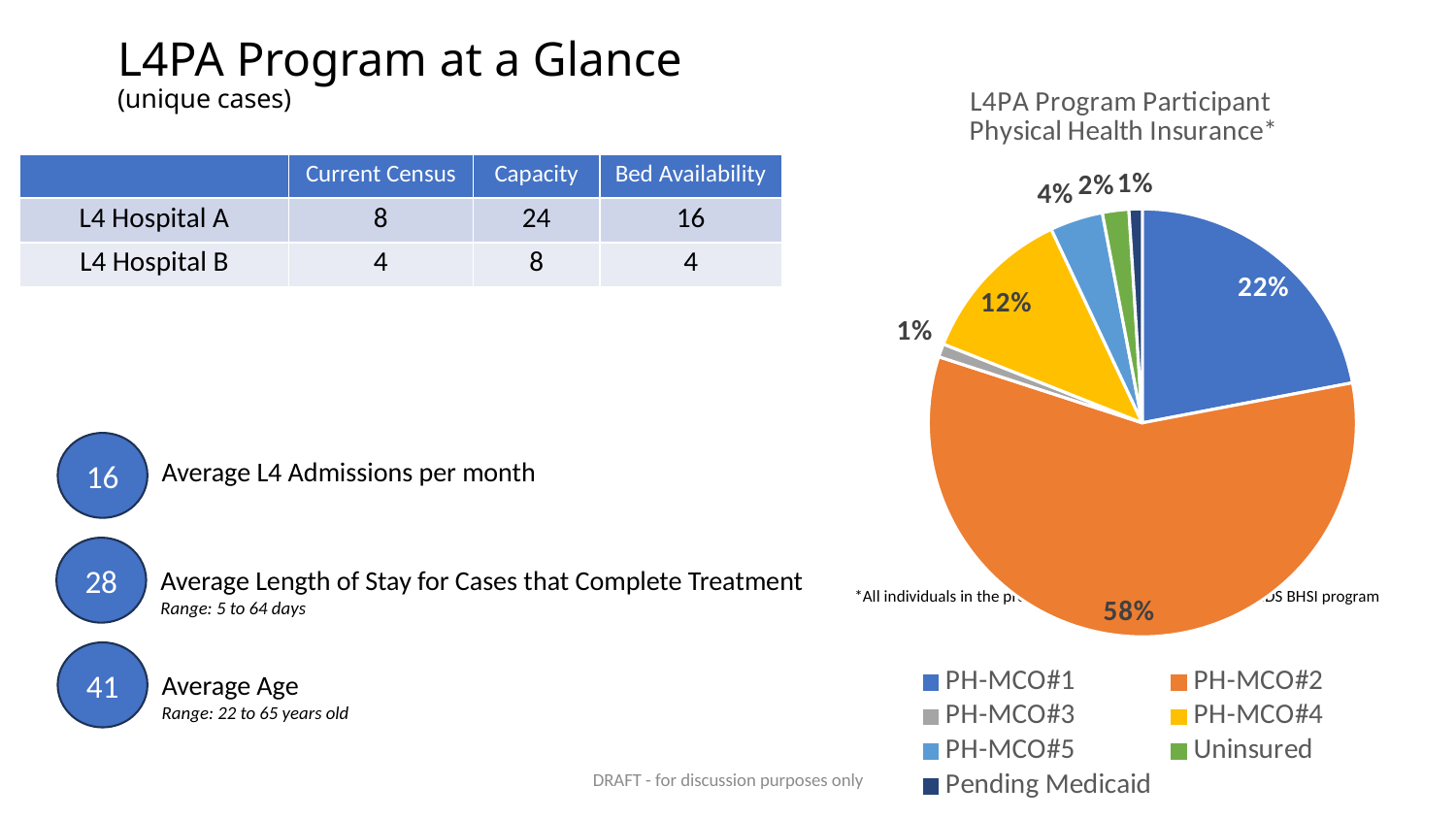
What share of the pie does Uninsured represent? 2% What share of the pie does PH-MCO#4 represent? 12% What share of the pie does PH-MCO#1 represent? 22% How many categories does the pie chart's legend list? 7 Which is larger, the share for PH-MCO#1 or the share for PH-MCO#4? PH-MCO#1 Which category has the largest slice of the pie? PH-MCO#2 What is the difference in percentage points between the PH-MCO#2 share and the PH-MCO#1 share? 36% What type of chart is shown on the slide? Pie chart Which colour represents PH-MCO#4 in the pie chart? Yellow What is the title of the pie chart? L4PA Program Participant Physical Health Insurance*